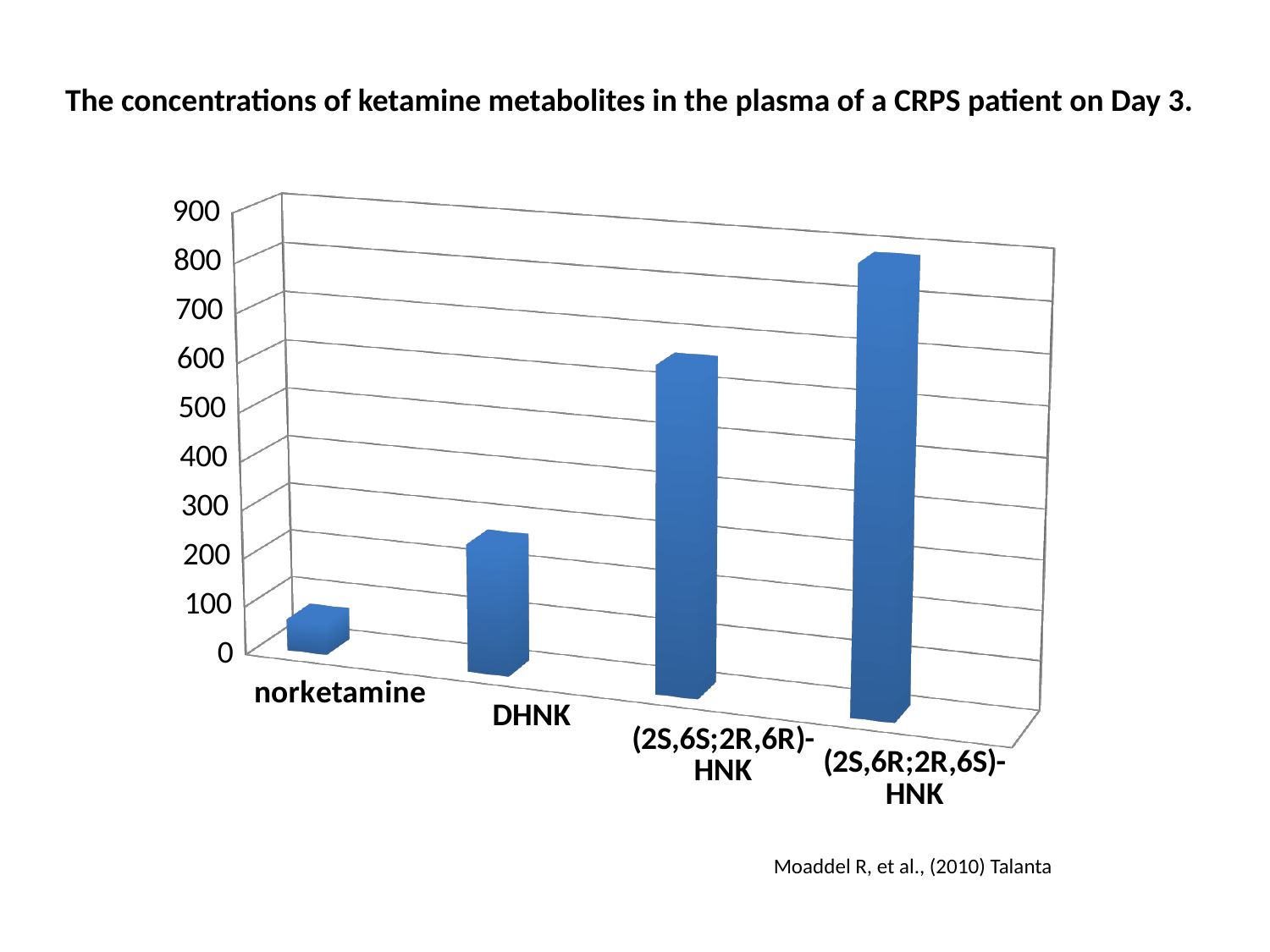
How many metabolites (categories) are plotted in the chart? 4 Do the values rise or fall moving from left to right along the x axis? rise What is the title of the chart on the slide? The concentrations of ketamine metabolites in the plasma of a CRPS patient on Day 3. Is the value for DHNK greater or less than 300? less Which metabolite has the highest concentration in the chart? (2S,6R;2R,6S)-HNK Is the value for norketamine greater or less than 100? less Which is larger, the value for DHNK or the value for (2S,6S;2R,6R)-HNK? (2S,6S;2R,6R)-HNK Is the value for (2S,6R;2R,6S)-HNK greater or less than 700? greater What kind of chart is shown on the slide? bar chart Which metabolite has the lowest concentration in the chart? norketamine